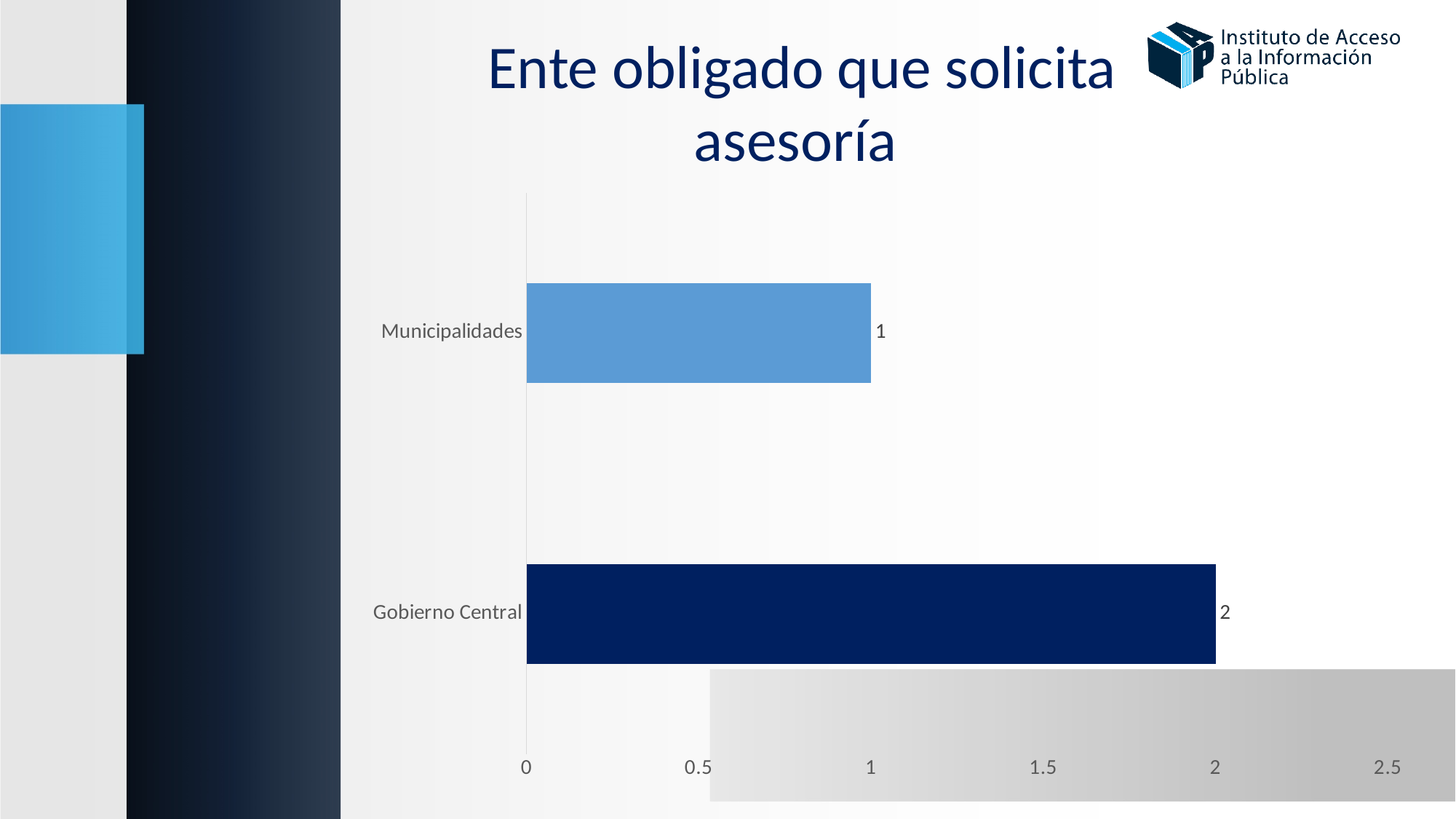
What is the value for Gobierno Central? 2 Which category has the highest value? Gobierno Central What is the difference between the values for Gobierno Central and Municipalidades? 1 What is the highest value shown on the x axis? 2.5 Is the value for Municipalidades greater or less than 1.5? less What is the value for Municipalidades? 1 How many categories are shown in the chart? 2 What kind of chart is shown on the slide? bar chart Which is larger, the value for Municipalidades or the value for Gobierno Central? Gobierno Central Is the value for Gobierno Central greater or less than 1.5? greater Which category has the lowest value? Municipalidades What is the title of the slide? Ente obligado que solicita asesoría